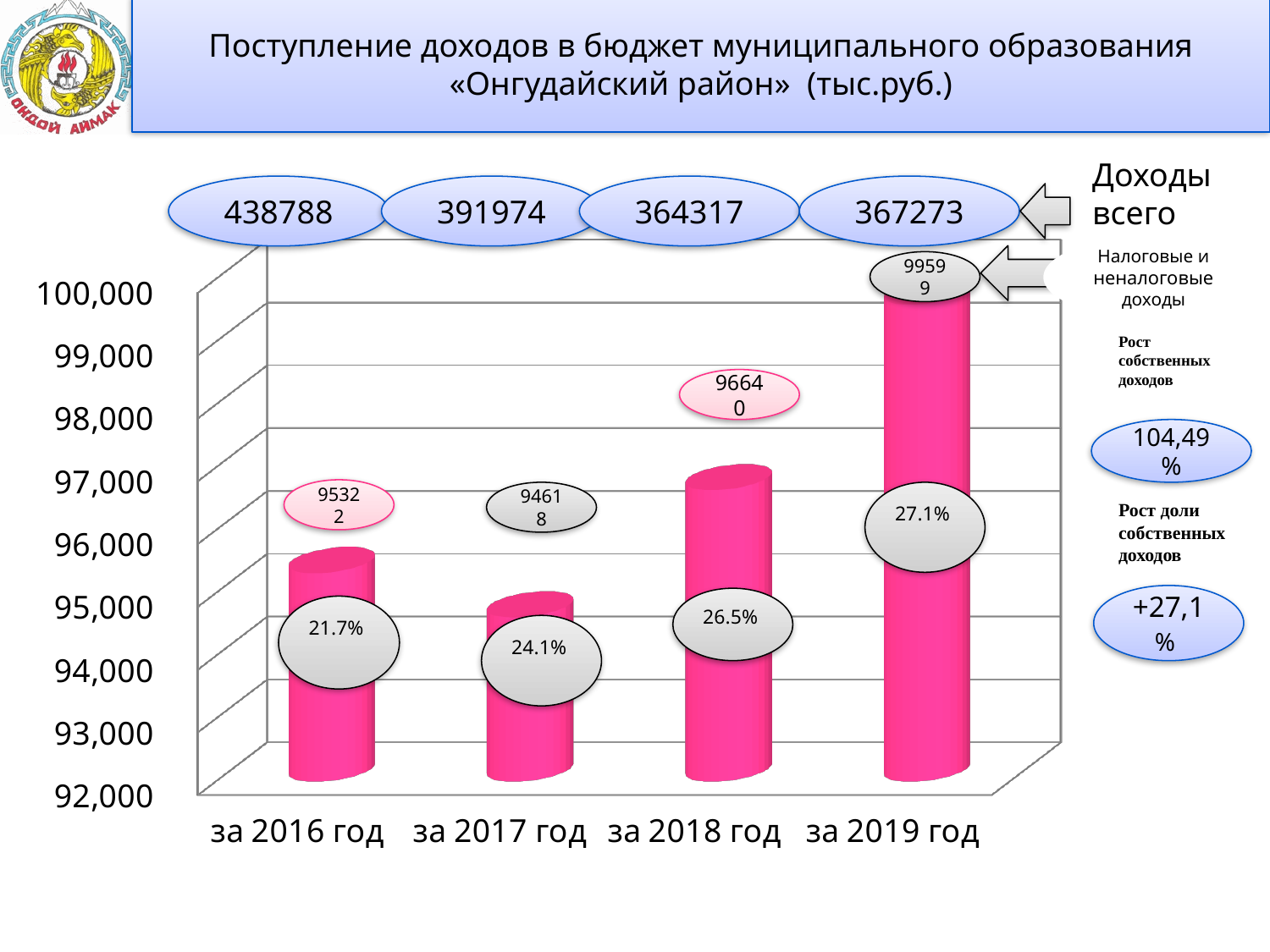
What total income (Доходы всего) is shown in the oval above the bar for за 2016 год? 438788 Which bar is taller, за 2016 год or за 2017 год? за 2016 год Which year has the highest bar in the chart? за 2019 год What value is labelled on the bar for за 2017 год? 94618 What percentage is shown in the circle on the bar for за 2018 год? 26.5% What kind of chart is shown on the slide? bar chart Is the value for за 2018 год greater or less than 96,000? greater How many bars (years) are plotted in the chart? 4 What is the difference between the labelled values for за 2019 год and за 2018 год? 2959 Do the bar values rise or fall from за 2017 год to за 2019 год? rise What value is labelled on the bar for за 2019 год? 99599 Which year has the lowest bar in the chart? за 2017 год